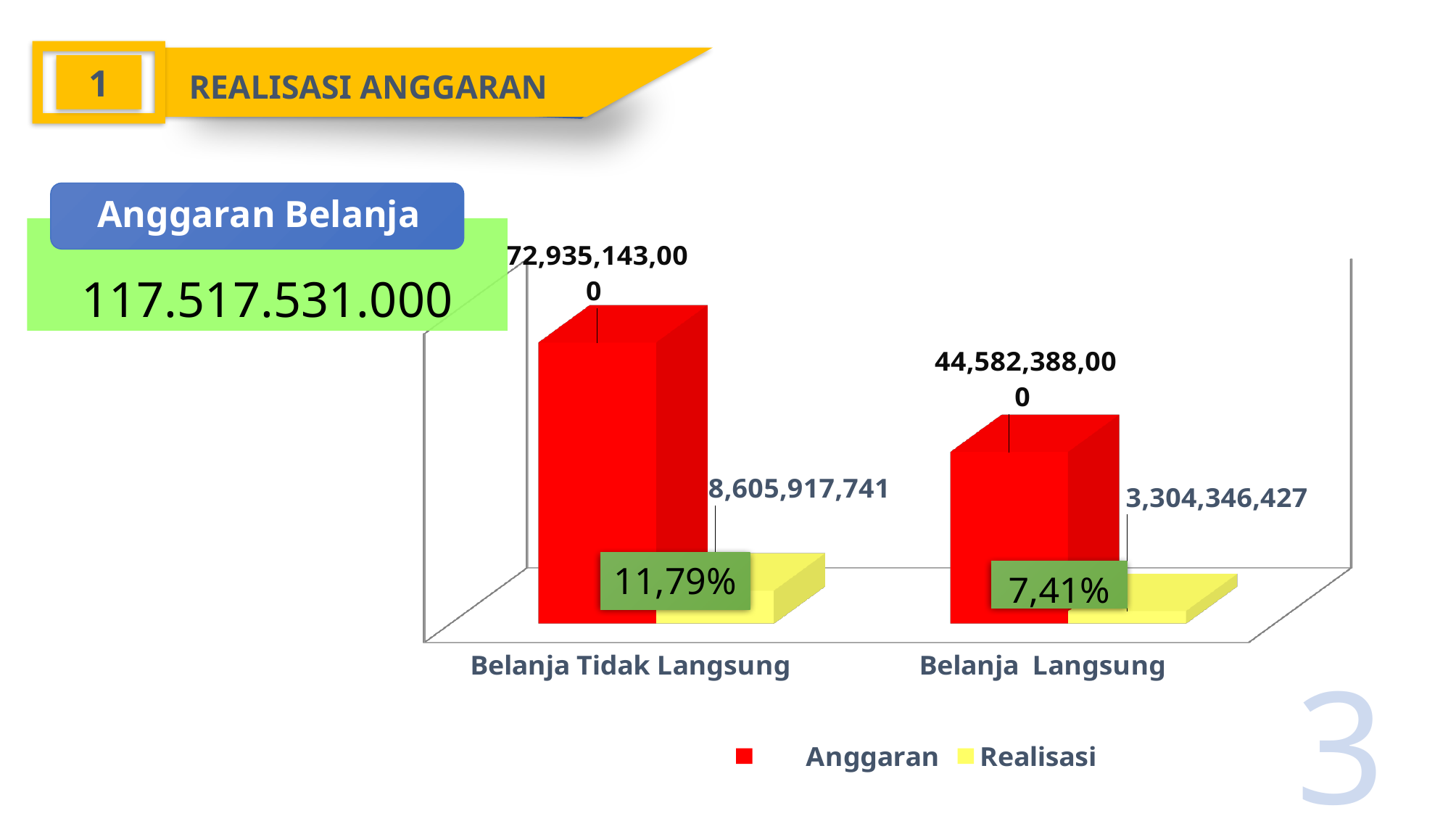
Which category has the lower Realisasi value? Belanja Langsung How many categories are shown on the x axis of the chart? 2 What is the Realisasi value for Belanja Tidak Langsung? 8,605,917,741 What is the Realisasi value for Belanja Langsung? 3,304,346,427 Which category has the higher Anggaran value? Belanja Tidak Langsung What is the difference between the Anggaran and Realisasi values for Belanja Langsung? 41,278,041,573 What kind of chart is shown on the slide? bar chart What is the Anggaran value for Belanja Tidak Langsung? 72,935,143,000 What is the Anggaran value for Belanja Langsung? 44,582,388,000 How many series does the chart legend list? 2 Is the Realisasi value for Belanja Tidak Langsung larger or smaller than the Anggaran value for Belanja Langsung? smaller What is the difference between the Anggaran values for Belanja Tidak Langsung and Belanja Langsung? 28,352,755,000